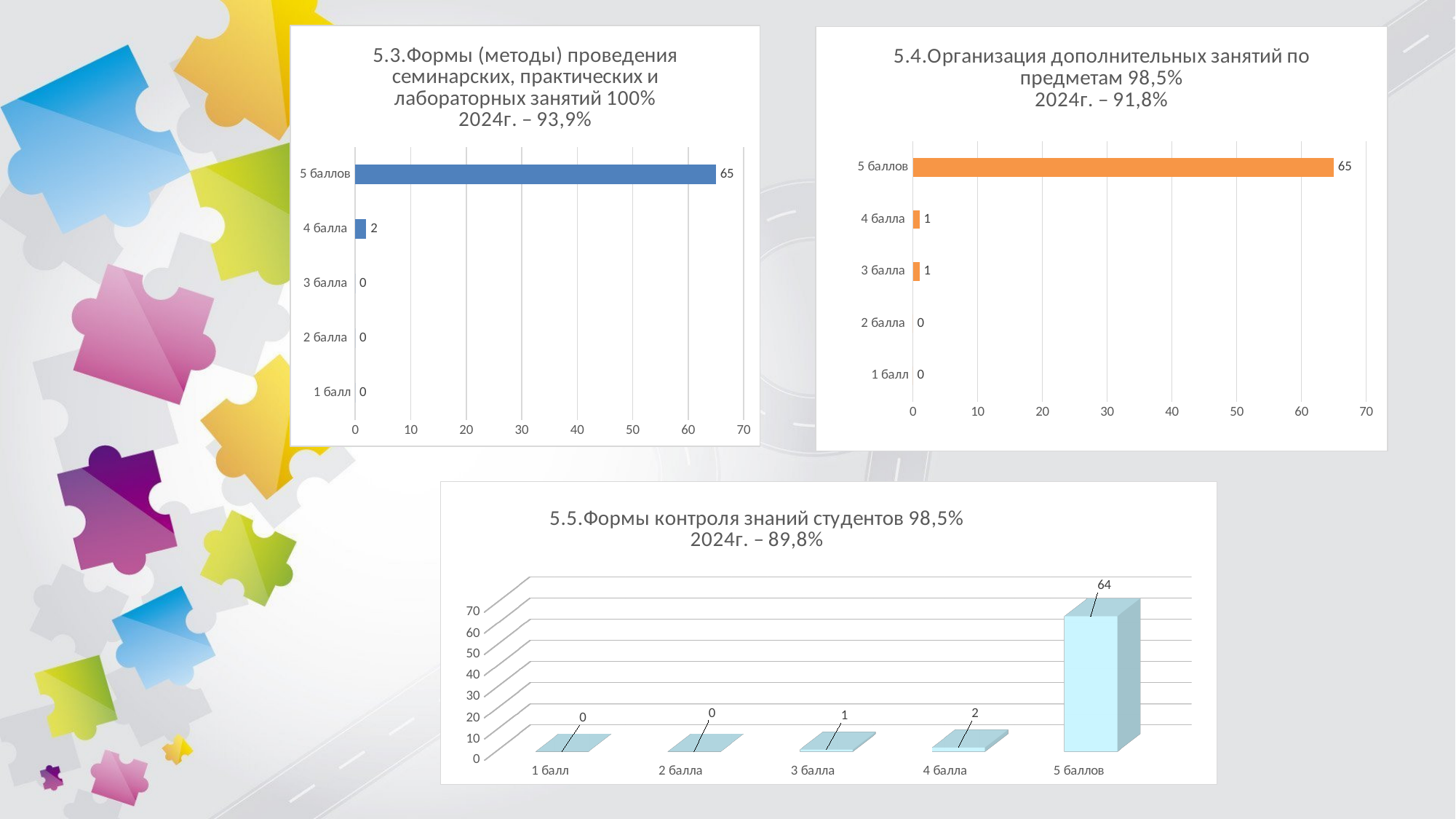
In the chart titled "5.4.Организация дополнительных занятий по предметам", is the value for "5 баллов" greater or less than 60? greater In the chart titled "5.5.Формы контроля знаний студентов", what is the value for "4 балла"? 2 In the chart titled "5.5.Формы контроля знаний студентов", what is the value for "5 баллов"? 64 In the chart titled "5.4.Организация дополнительных занятий по предметам", how many categories are shown? 5 What type of chart is the chart titled "5.3.Формы (методы) проведения семинарских, практических и лабораторных занятий"? bar chart In the chart titled "5.4.Организация дополнительных занятий по предметам", which category has the highest value? 5 баллов In the chart titled "5.3.Формы (методы) проведения семинарских, практических и лабораторных занятий", what is the value for "4 балла"? 2 In the chart titled "5.3.Формы (методы) проведения семинарских, практических и лабораторных занятий", what is the value for "5 баллов"? 65 In the chart titled "5.3.Формы (методы) проведения семинарских, практических и лабораторных занятий", what is the difference between the values for "5 баллов" and "4 балла"? 63 In the chart titled "5.5.Формы контроля знаний студентов", do the values rise or fall from "1 балл" to "5 баллов"? rise In the chart titled "5.4.Организация дополнительных занятий по предметам", what is the value for "3 балла"? 1 In the chart titled "5.5.Формы контроля знаний студентов", which is larger, the value for "3 балла" or the value for "4 балла"? 4 балла